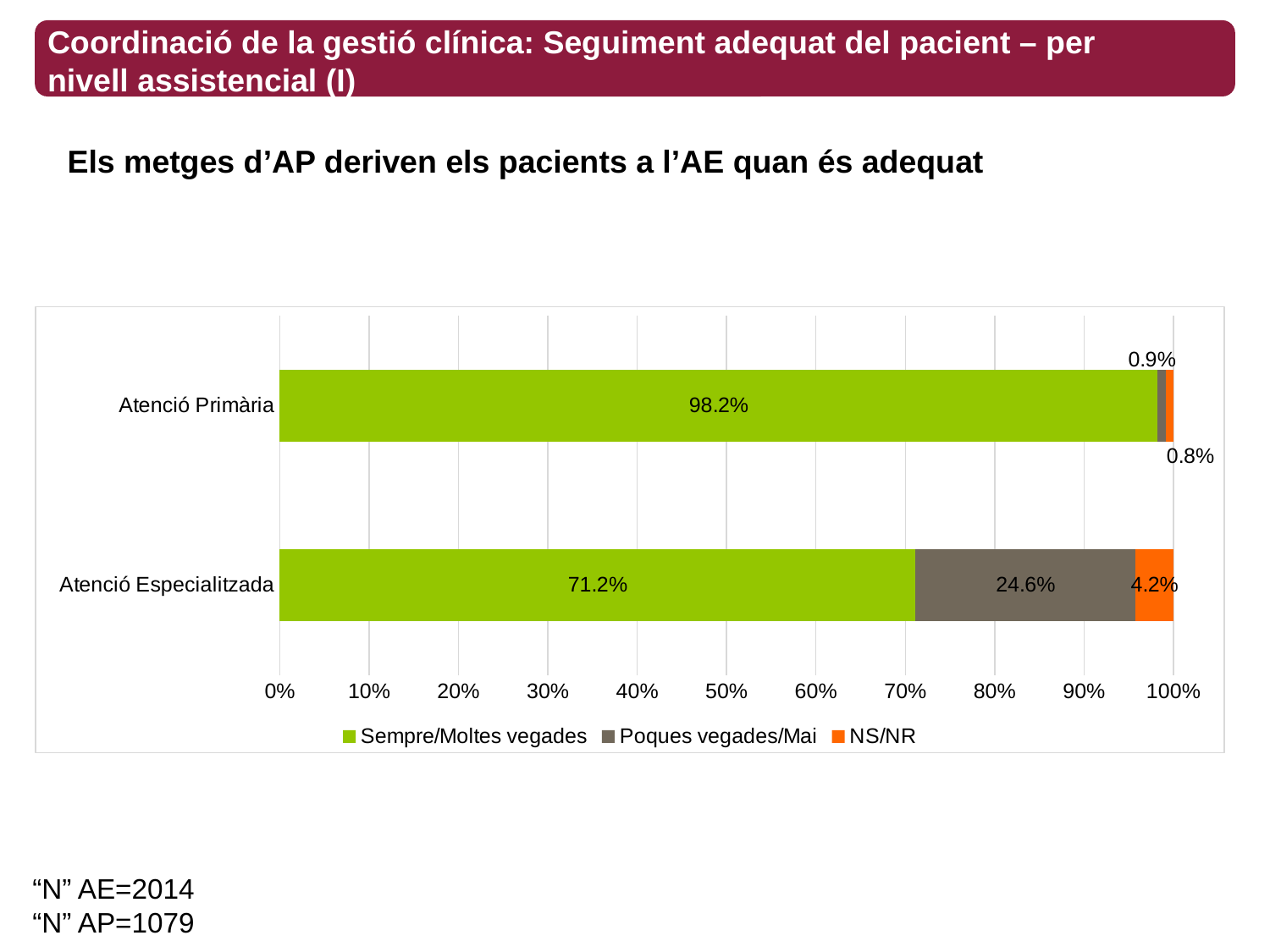
Which is larger for Atenció Especialitzada: Poques vegades/Mai or NS/NR? Poques vegades/Mai What kind of chart is shown on the slide? Stacked bar chart What is the value of Sempre/Moltes vegades for Atenció Primària? 98.2% How many series does the legend list? 3 Is the Sempre/Moltes vegades value for Atenció Especialitzada greater or less than 70%? greater What is the difference between the Sempre/Moltes vegades values for Atenció Primària and Atenció Especialitzada? 27.0% How many categories are plotted on the chart? 2 Which category has the higher value for Sempre/Moltes vegades? Atenció Primària Which legend entry is shown in orange? NS/NR What is the value of Poques vegades/Mai for Atenció Especialitzada? 24.6% What is the value of Sempre/Moltes vegades for Atenció Especialitzada? 71.2% What is the value of NS/NR for Atenció Especialitzada? 4.2%